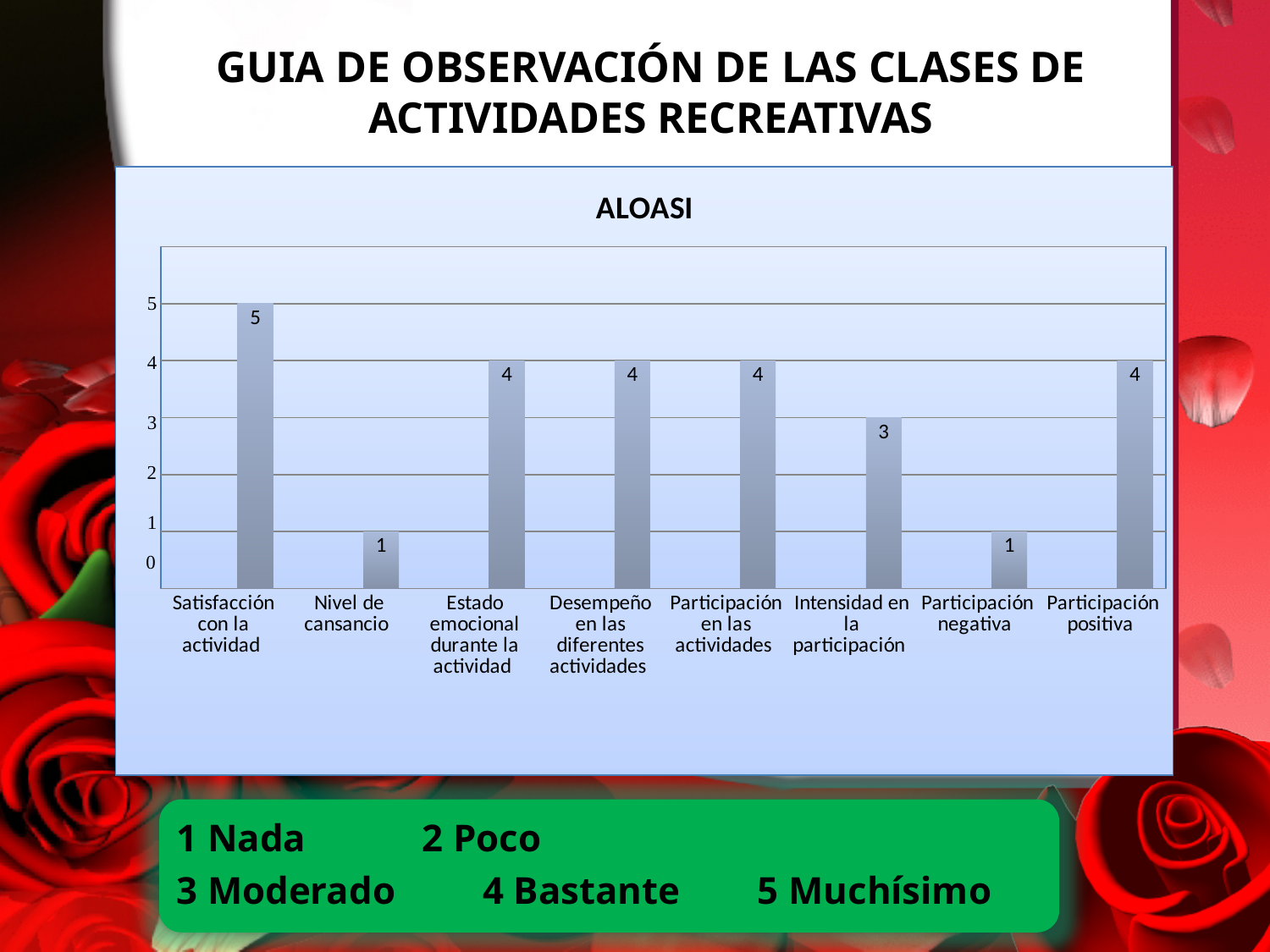
How many categories have a value of 4? 4 Which is larger, the value for Participación negativa or the value for Participación positiva? Participación positiva What is the value for Satisfacción con la actividad? 5 What is the difference between the values for Satisfacción con la actividad and Intensidad en la participación? 2 Is the value for Estado emocional durante la actividad greater or less than 2? greater How many categories are shown on the x axis? 8 Which category has the highest value? Satisfacción con la actividad What is the title of the chart? ALOASI What is the value for Participación positiva? 4 What is the value for Nivel de cansancio? 1 What is the value for Intensidad en la participación? 3 What kind of chart is shown? bar chart